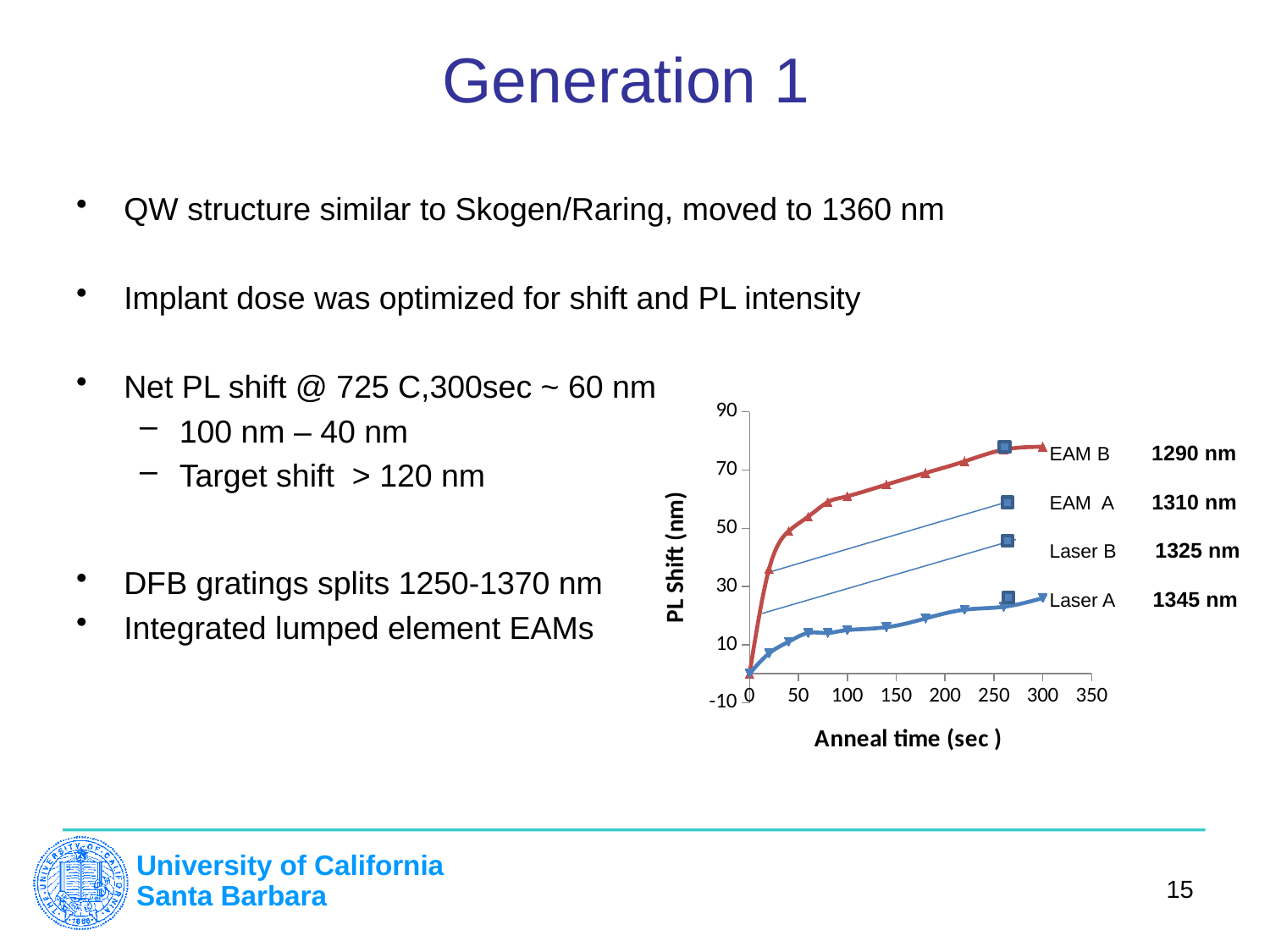
What kind of chart is shown on the slide? line chart What is the title of the x axis of the chart? Anneal time (sec ) Is the value of the red (upper) line at 300 sec greater or less than 70? greater At 200 sec, which line has the larger PL shift, the red line or the blue line? the red line Is the value of the blue (lower) line at 300 sec greater or less than 10? greater Is the value of the blue (lower) line at 300 sec greater or less than 30? less Does the blue (lower) line rise or fall as anneal time increases? rise What is the highest tick value shown on the y axis of the chart? 90 What is the title of the y axis of the chart? PL Shift (nm) Does the red (upper) line rise or fall as anneal time increases? rise